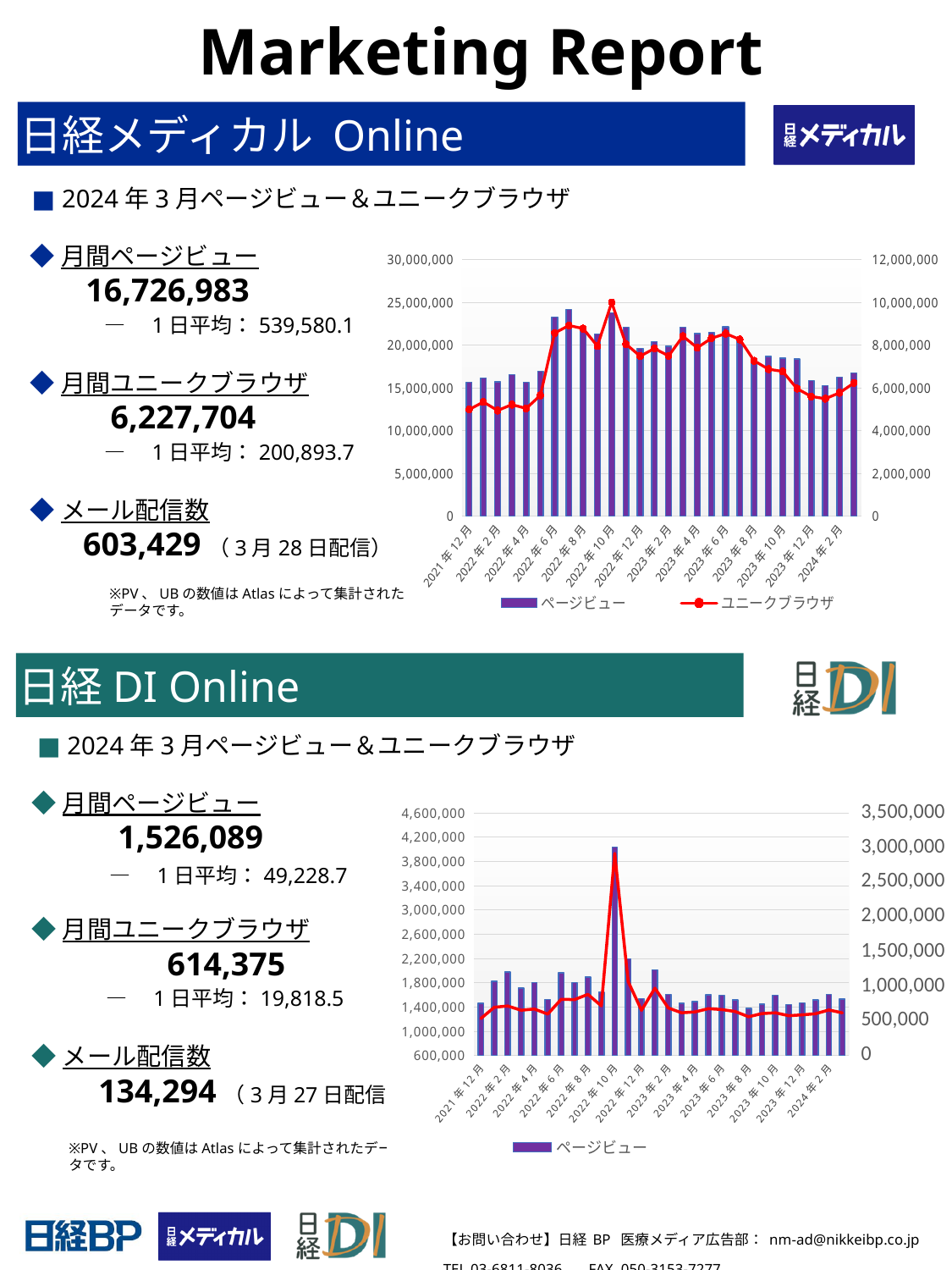
In the 日経メディカル Online chart, at which month does the ユニークブラウザ line reach its highest point? 2022年10月 In the 日経メディカル Online chart, is the ページビュー value for 2021年12月 greater or less than 20,000,000? less How many series does the legend of the 日経 DI Online chart list? 1 How many series does the legend of the 日経メディカル Online chart list? 2 In the 日経メディカル Online chart, do the ページビュー bars rise or fall from 2023年6月 to 2023年12月? fall In the 日経 DI Online chart, which month has the highest ページビュー bar? 2022年10月 In the 日経 DI Online chart, is the ページビュー value for 2022年10月 greater or less than 3,400,000? greater What are the two legend entries of the 日経メディカル Online chart? ページビュー, ユニークブラウザ In the 日経メディカル Online chart, is the ページビュー value for 2022年8月 greater or less than 20,000,000? greater What is the highest value shown on the left axis of the 日経 DI Online chart? 4,600,000 What kind of chart is shown in the 日経メディカル Online section? bar chart with a line